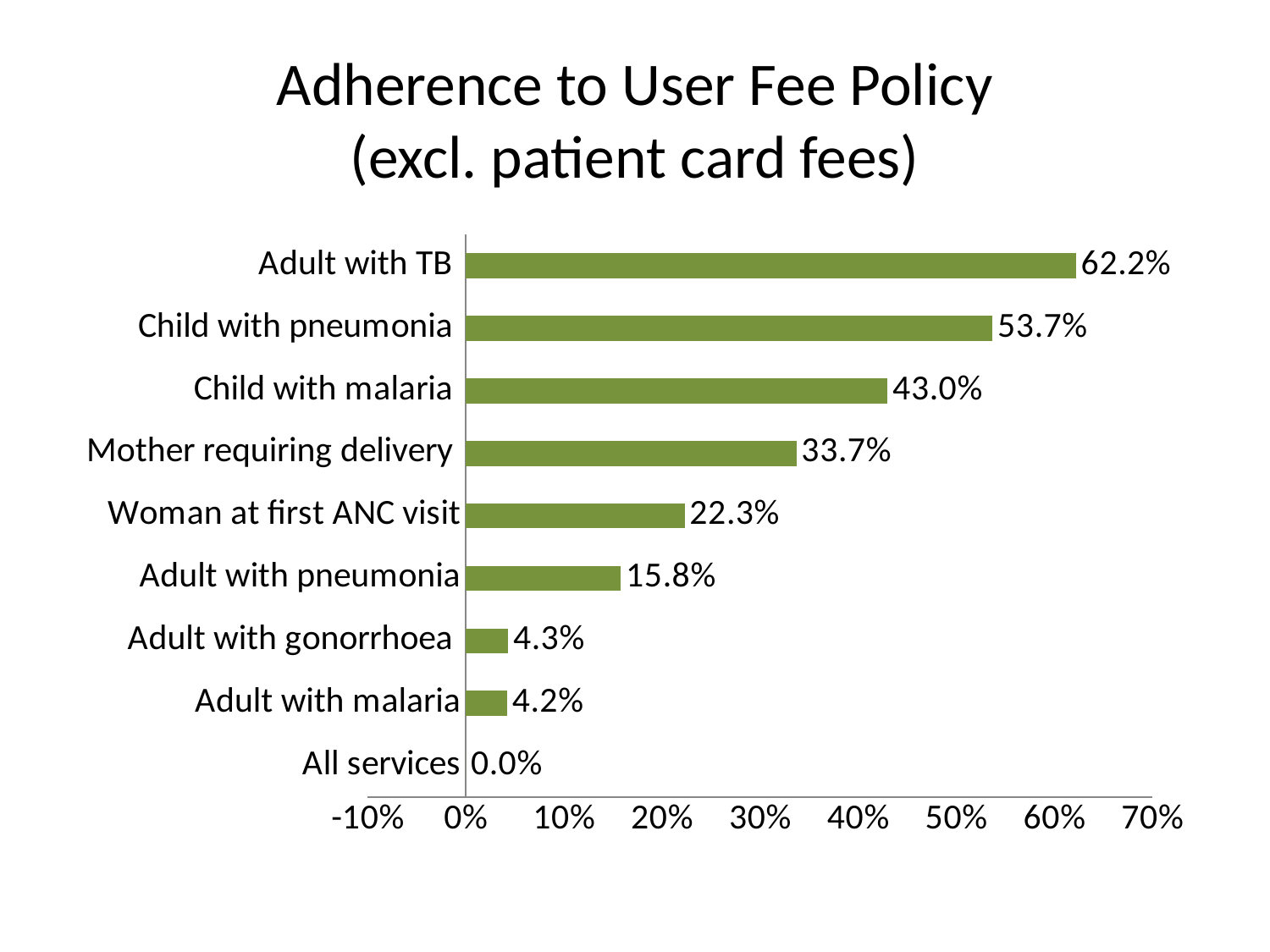
What is the value for All services? 0.0% Is the value for Child with malaria greater or less than 40%? greater Which category has the highest value? Adult with TB What is the value for Adult with TB? 62.2% What is the value for Adult with gonorrhoea? 4.3% Which category has the lowest value? All services What is the difference between the values for Child with pneumonia and Child with malaria? 10.7% Which is larger, the value for Woman at first ANC visit or the value for Adult with pneumonia? Woman at first ANC visit What is the value for Mother requiring delivery? 33.7% What is the title of the chart? Adherence to User Fee Policy (excl. patient card fees) How many categories are shown on the chart? 9 What kind of chart is shown on the slide? Bar chart